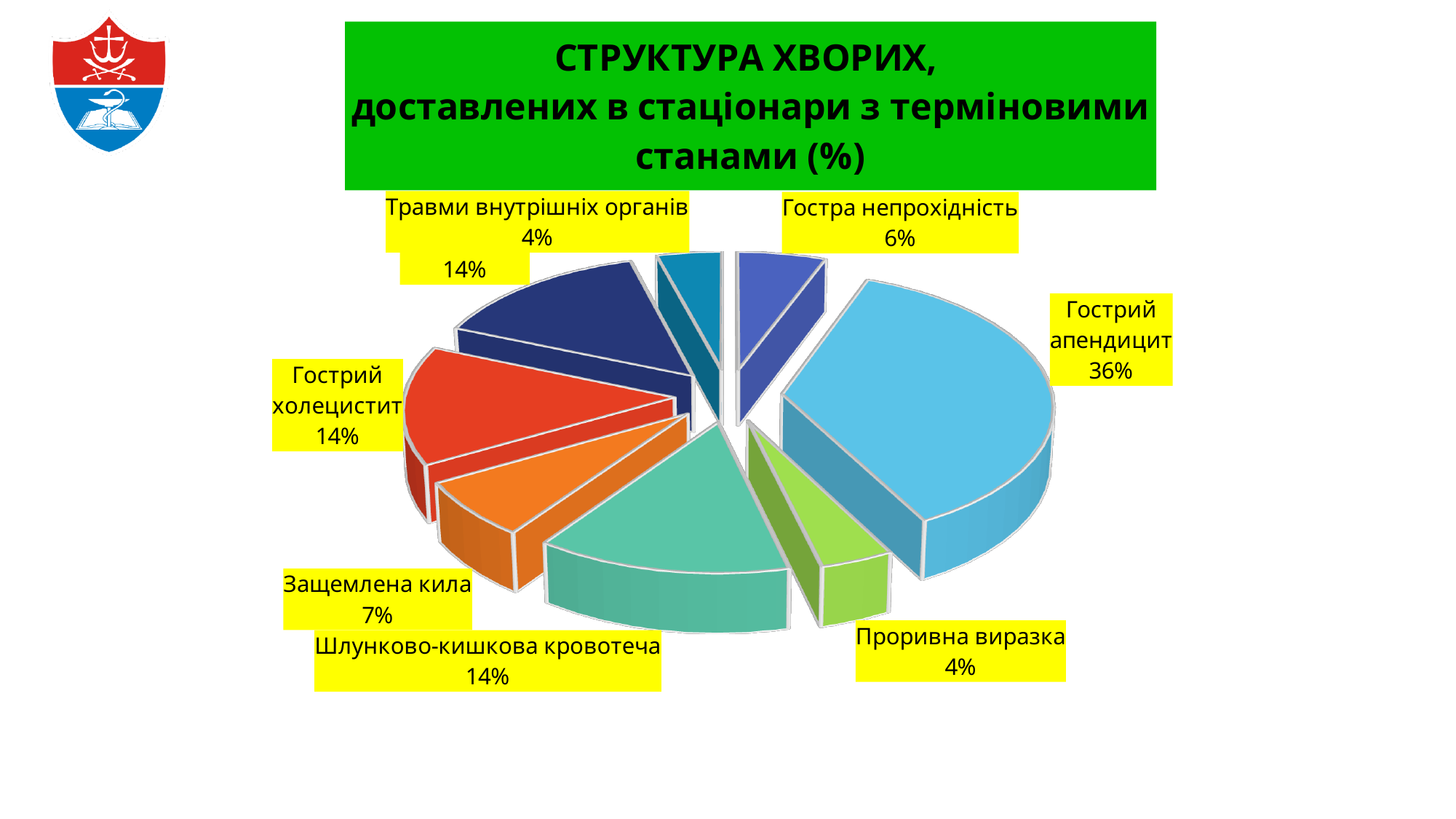
What is the value for Проривна виразка? 4% What is the value for Шлунково-кишкова кровотеча? 14% How many slices does the pie chart have? 8 What is the difference between the values for Гострий апендицит and Гострий холецистит? 22% What is the value for Гостра непрохідність? 6% What is the value for Травми внутрішніх органів? 4% Which category has the largest share of the pie? Гострий апендицит What kind of chart is shown on the slide? pie chart Which is larger, the value for Защемлена кила or the value for Гостра непрохідність? Защемлена кила What is the value for Гострий апендицит? 36% What is the difference between the values for Шлунково-кишкова кровотеча and Защемлена кила? 7% What is the value for Защемлена кила? 7%